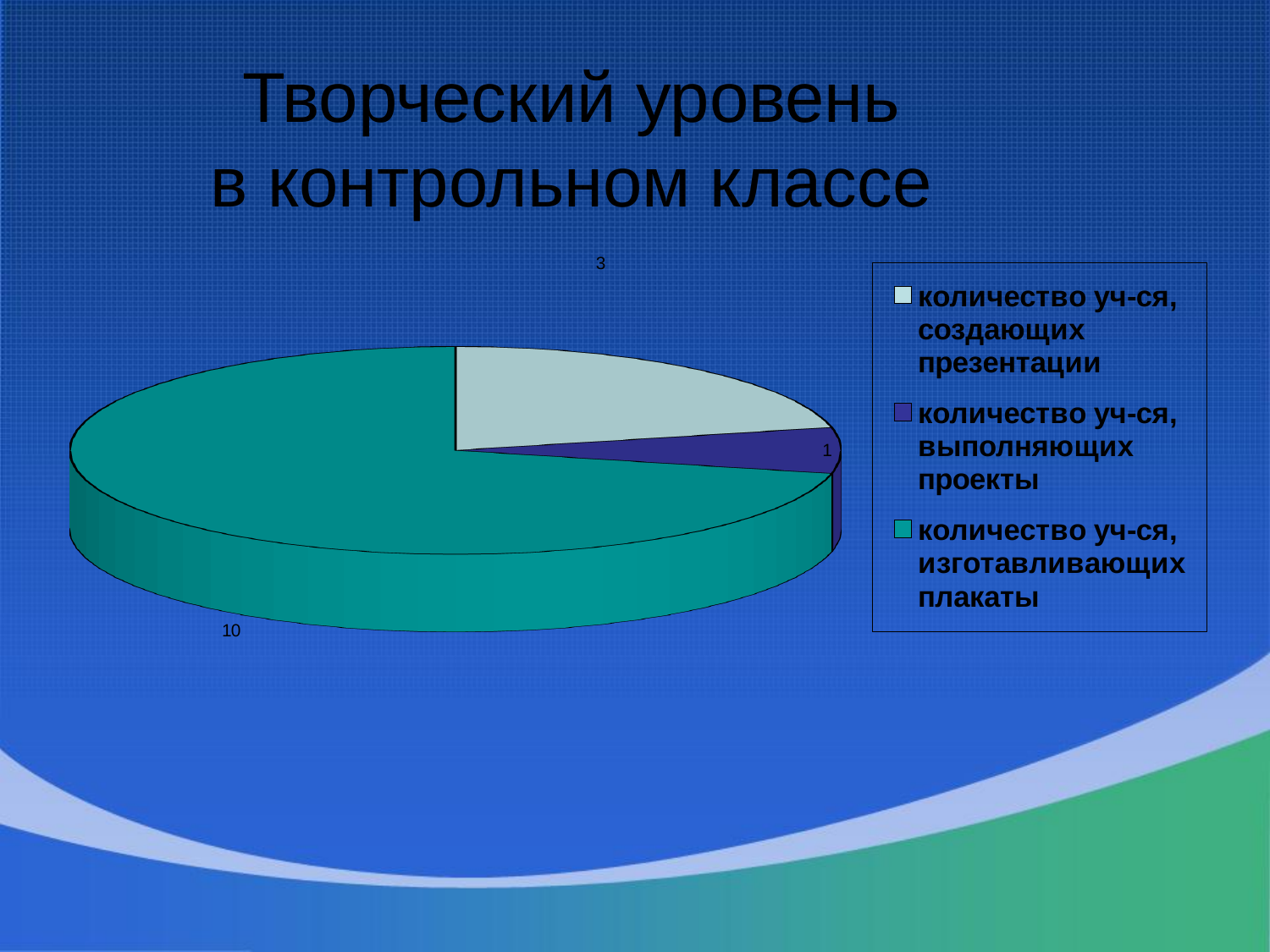
What is the total of all slices in the pie chart? 14 What is the difference between the value for students making posters and the value for students creating presentations? 7 How many entries does the legend list? 3 How many slices does the pie chart have? 3 Which category has the smallest slice of the pie? количество уч-ся, выполняющих проекты What is the value for 'количество уч-ся, изготавливающих плакаты'? 10 Which category has the largest slice of the pie? количество уч-ся, изготавливающих плакаты What is the title of the slide containing the chart? Творческий уровень в контрольном классе Which is larger: the value for students creating presentations or the value for students doing projects? количество уч-ся, создающих презентации What kind of chart is shown on the slide? pie chart What is the value for 'количество уч-ся, выполняющих проекты'? 1 What is the value for 'количество уч-ся, создающих презентации'? 3